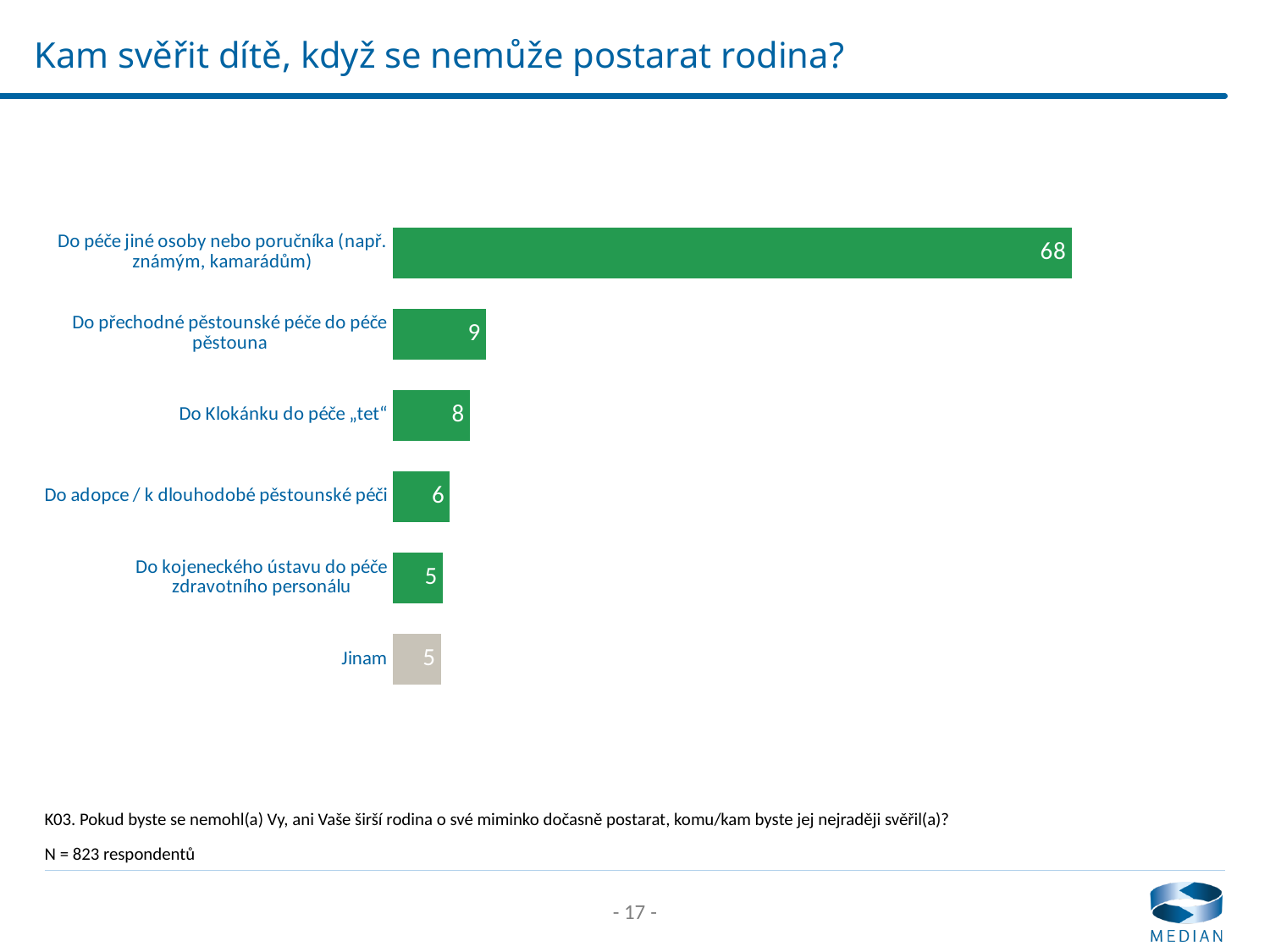
What is the value for "Do adopce / k dlouhodobé pěstounské péči"? 6 What kind of chart is shown on the slide? bar chart Which category has the highest value? Do péče jiné osoby nebo poručníka (např. známým, kamarádům) What is the difference between the values for "Do Klokánku do péče „tet“" and "Do adopce / k dlouhodobé pěstounské péči"? 2 Which is larger, the value for "Do přechodné pěstounské péče do péče pěstouna" or the value for "Do kojeneckého ústavu do péče zdravotního personálu"? Do přechodné pěstounské péče do péče pěstouna What is the value for "Do Klokánku do péče „tet“"? 8 How many categories are shown in the chart? 6 What is the value for "Do přechodné pěstounské péče do péče pěstouna"? 9 Which bar is shown in a different colour (grey) from the others? Jinam What is the value for "Jinam"? 5 What is the difference between the values for "Do péče jiné osoby nebo poručníka (např. známým, kamarádům)" and "Do přechodné pěstounské péče do péče pěstouna"? 59 What is the value for "Do péče jiné osoby nebo poručníka (např. známým, kamarádům)"? 68